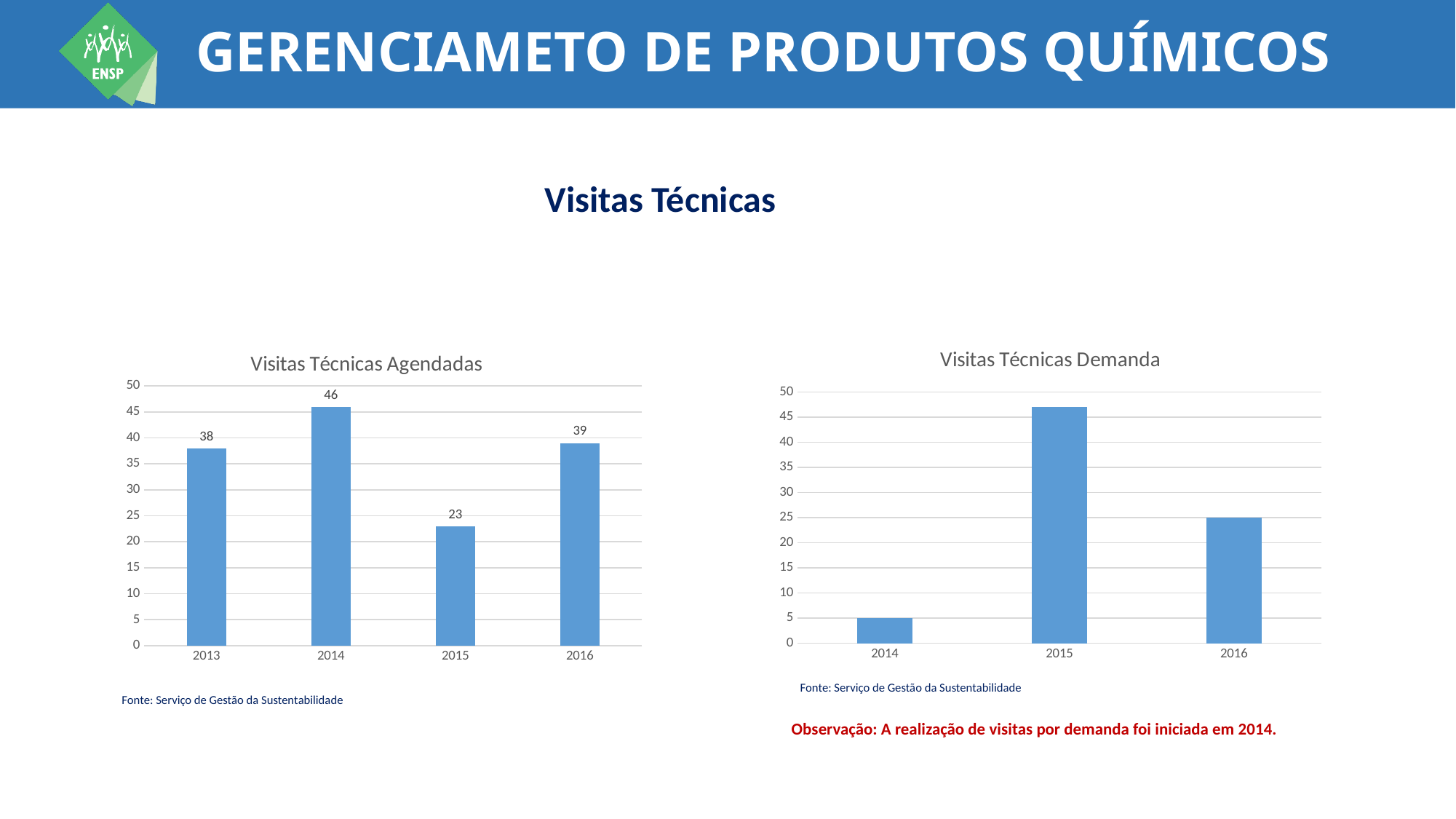
In the 'Visitas Técnicas Demanda' chart, is the value for 2015 greater or less than 45? greater In the 'Visitas Técnicas Demanda' chart, is the value for 2016 greater or less than 20? greater In the 'Visitas Técnicas Agendadas' chart, which year has the highest value? 2014 In the 'Visitas Técnicas Agendadas' chart, which year has the lowest value? 2015 In the 'Visitas Técnicas Agendadas' chart, which is larger, the value for 2013 or the value for 2016? 2016 In the 'Visitas Técnicas Agendadas' chart, what is the value for 2015? 23 In the 'Visitas Técnicas Agendadas' chart, what is the value for 2014? 46 In the 'Visitas Técnicas Demanda' chart, which year has the highest value? 2015 How many years are shown in the 'Visitas Técnicas Demanda' chart? 3 In the 'Visitas Técnicas Agendadas' chart, what is the difference between the values for 2014 and 2015? 23 How many years are shown in the 'Visitas Técnicas Agendadas' chart? 4 What kind of chart is the 'Visitas Técnicas Demanda' chart? bar chart